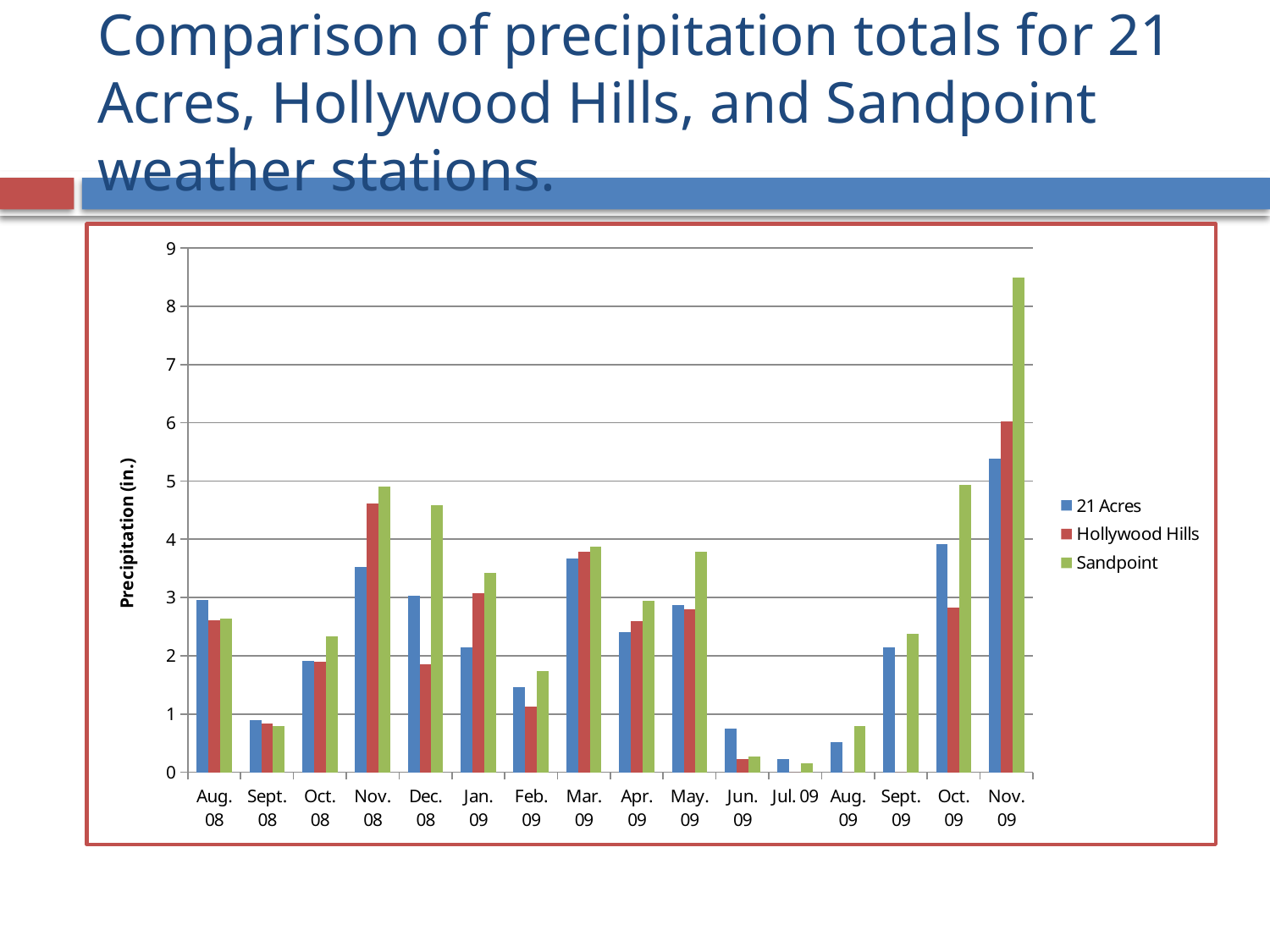
What is the label on the vertical axis? Precipitation (in.) How many series does the legend list? 3 Is the Hollywood Hills value for Dec. 08 greater or less than 2? less In Dec. 08, which station has the larger precipitation, Sandpoint or Hollywood Hills? Sandpoint In which month does 21 Acres have its lowest precipitation? Jul. 09 In which month does 21 Acres have its highest precipitation? Nov. 09 What kind of chart is shown on the slide? bar chart How many months are shown along the x axis? 16 Is the 21 Acres value for Nov. 08 greater or less than 3? greater In which month does Sandpoint have its highest precipitation? Nov. 09 In Aug. 08, which station has the larger precipitation, 21 Acres or Hollywood Hills? 21 Acres Is the Sandpoint value for Nov. 09 greater or less than 8? greater